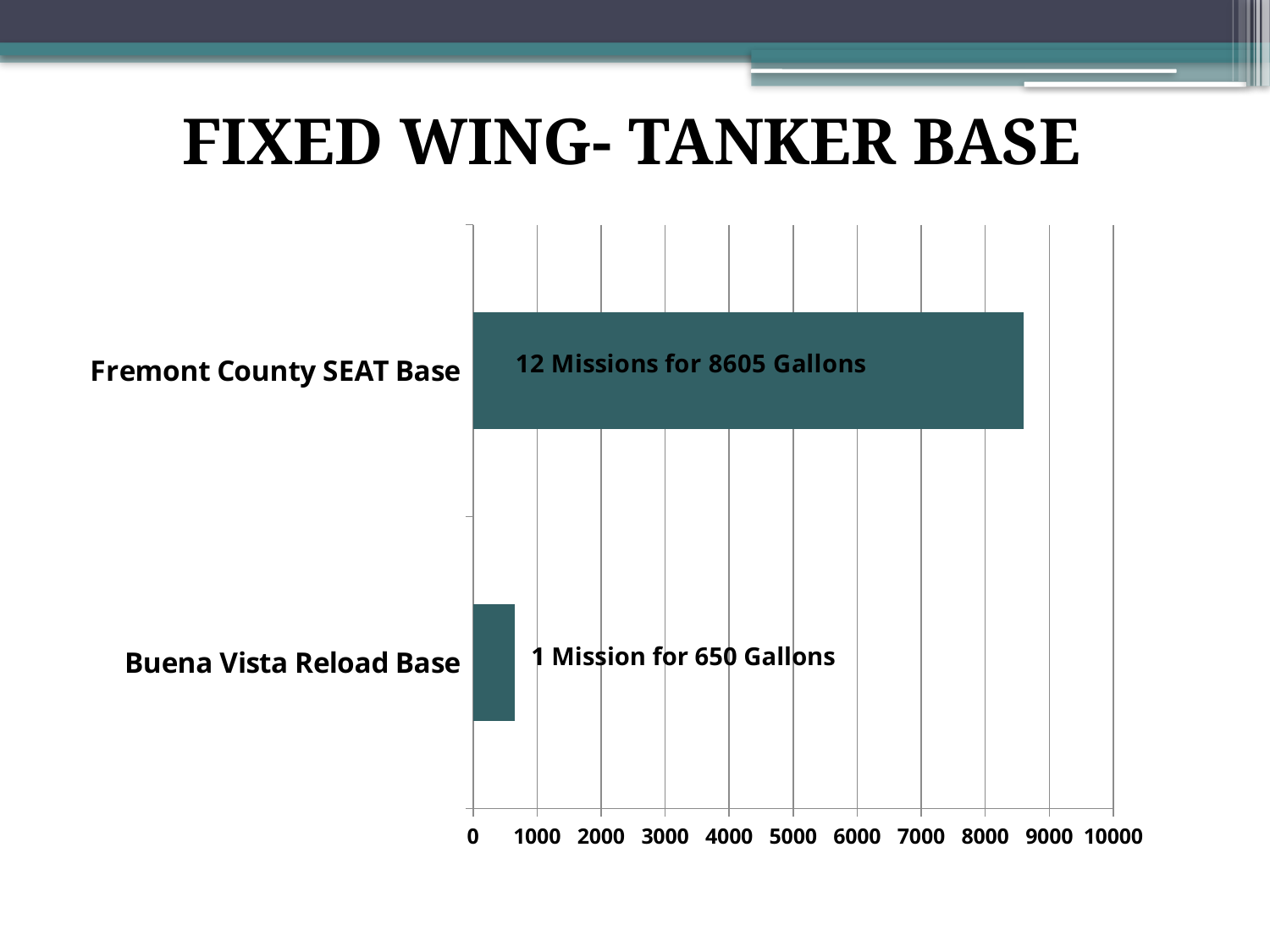
Which base has the highest gallons value? Fremont County SEAT Base What kind of chart is shown on the slide? Bar chart Which is larger, the gallons for Fremont County SEAT Base or for Buena Vista Reload Base? Fremont County SEAT Base How many gallons does the bar for Fremont County SEAT Base represent? 8605 Gallons Which base has the lowest gallons value? Buena Vista Reload Base Is the value for Buena Vista Reload Base greater or less than 1000? less Is the value for Fremont County SEAT Base greater or less than 8000? greater How many missions are labelled for Fremont County SEAT Base? 12 Missions How many bases are shown in the chart? 2 What is the difference in gallons between Fremont County SEAT Base and Buena Vista Reload Base? 7955 How many gallons does the bar for Buena Vista Reload Base represent? 650 Gallons How many missions are labelled for Buena Vista Reload Base? 1 Mission